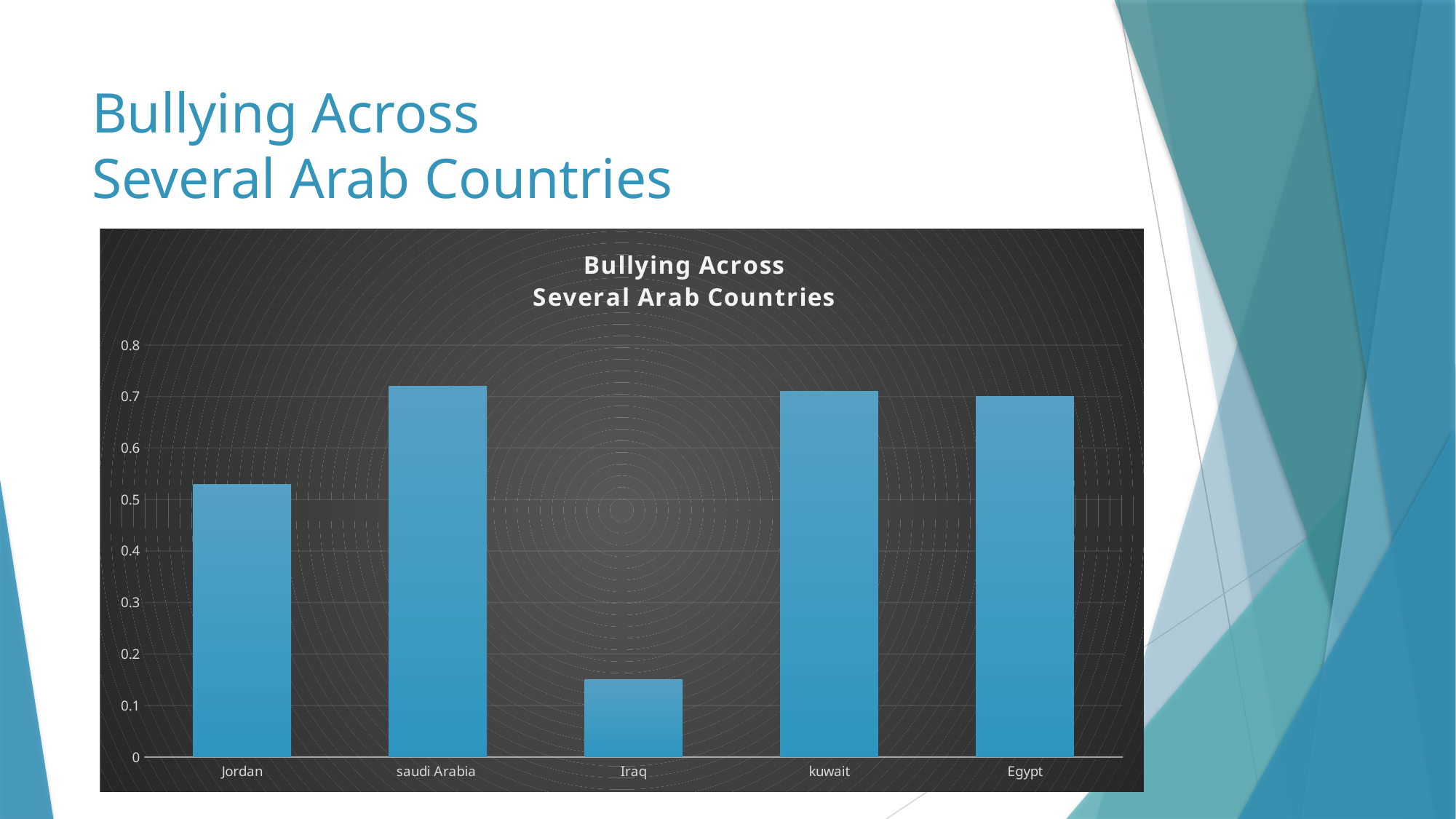
Is the value for Jordan greater or less than 0.5? greater How many countries are shown on the x axis of the chart? 5 Which has a larger value, Iraq or Egypt? Egypt What kind of chart is shown on the slide? bar chart What is the title of the chart? Bullying Across Several Arab Countries Which has a larger value, Jordan or saudi Arabia? saudi Arabia Is the value for Jordan greater or less than 0.6? less Which country has the lowest value in the chart? Iraq Is the value for Iraq greater or less than 0.2? less Which has a larger value, Jordan or Iraq? Jordan